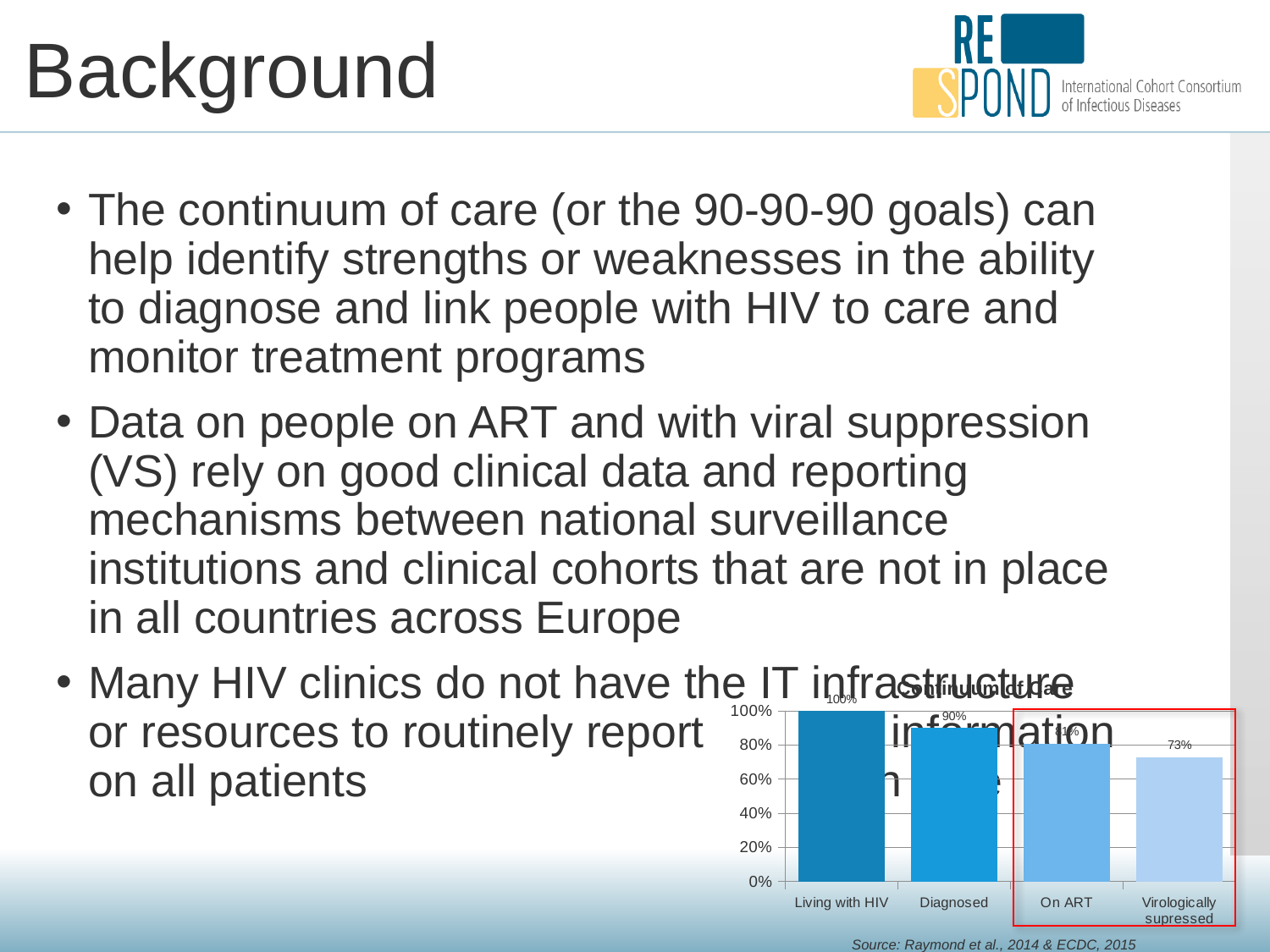
Is the value for On ART greater or less than 60%? greater What is the value for Virologically supressed in the Continuum of Care chart? 73% Which category has the lowest value in the Continuum of Care chart? Virologically supressed Which category has the highest value in the Continuum of Care chart? Living with HIV What is the difference between the values for Diagnosed and Virologically supressed? 17% What is the value for Diagnosed in the Continuum of Care chart? 90% What is the difference between the values for Living with HIV and Diagnosed? 10% What type of chart is shown on the slide? bar chart Which is larger, the value for Diagnosed or the value for On ART? Diagnosed What is the value for Living with HIV in the Continuum of Care chart? 100% Do the values rise or fall from left to right across the categories in the Continuum of Care chart? fall How many categories are shown in the Continuum of Care chart? 4